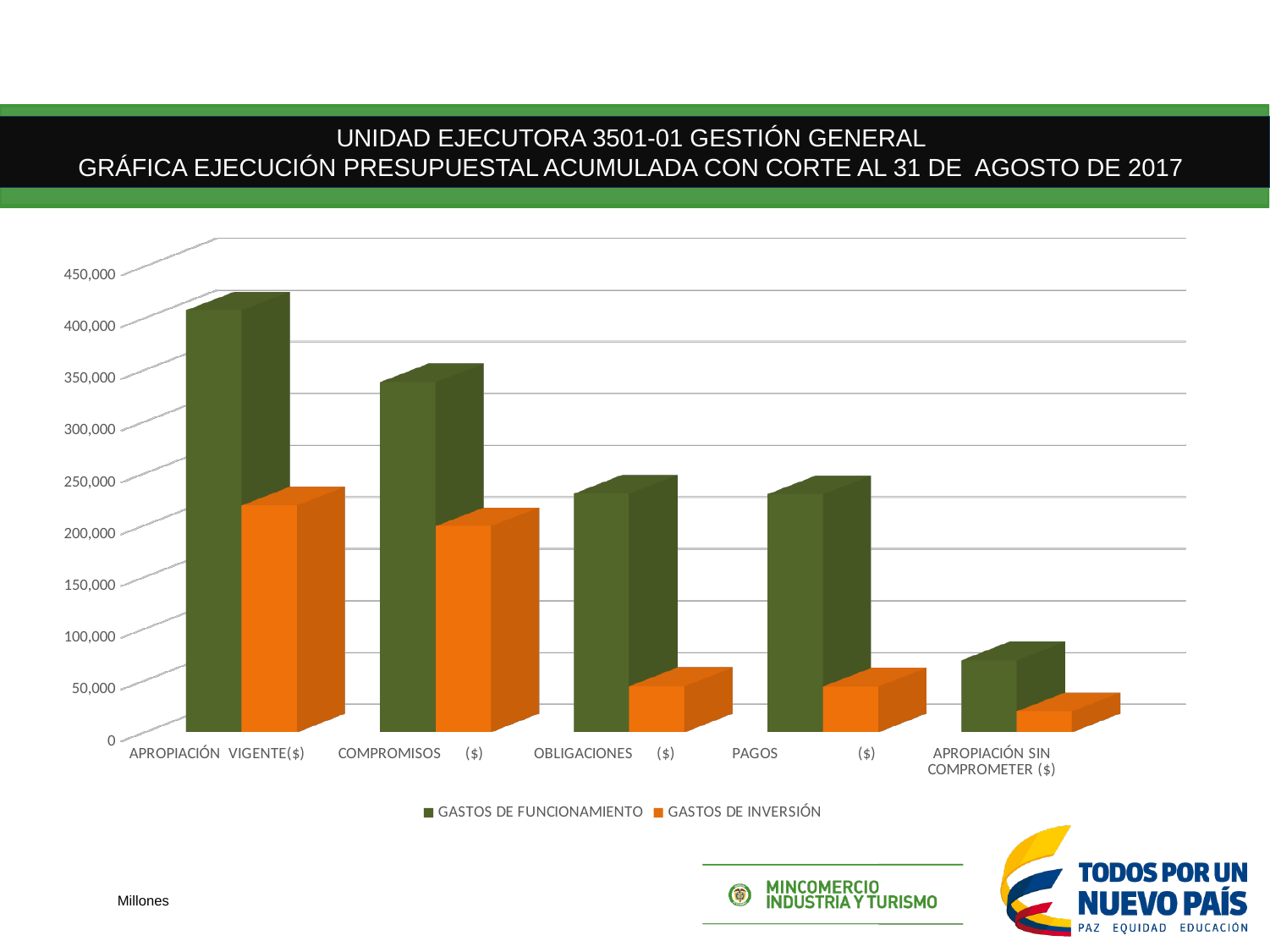
Do the GASTOS DE FUNCIONAMIENTO values overall rise or fall from left to right along the x axis? fall Is the GASTOS DE FUNCIONAMIENTO value for COMPROMISOS ($) greater or less than 300,000? greater Is the GASTOS DE INVERSIÓN value for OBLIGACIONES ($) greater or less than 100,000? less Which category has the highest value for GASTOS DE FUNCIONAMIENTO? APROPIACIÓN VIGENTE($) How many categories are shown on the x axis? 5 Is the GASTOS DE FUNCIONAMIENTO value for APROPIACIÓN SIN COMPROMETER ($) greater or less than 100,000? less How many series does the legend list? 2 What colour represents GASTOS DE INVERSIÓN in the legend? orange For COMPROMISOS ($), which series has the larger value, GASTOS DE FUNCIONAMIENTO or GASTOS DE INVERSIÓN? GASTOS DE FUNCIONAMIENTO What kind of chart is shown on the slide? bar chart Which category has the lowest value for GASTOS DE INVERSIÓN? APROPIACIÓN SIN COMPROMETER ($)